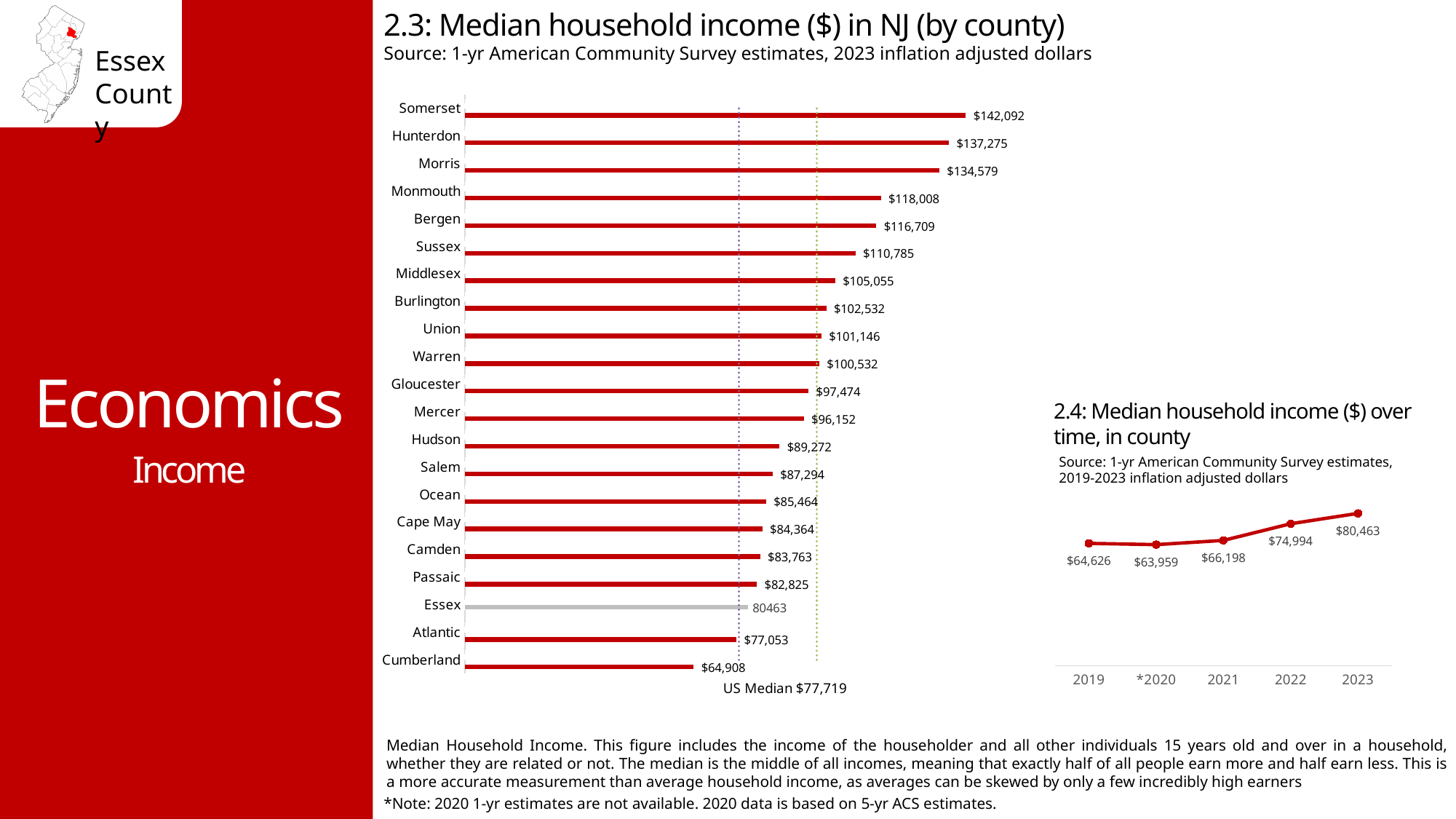
In chart 2.3 (Median household income in NJ by county), what is the median household income for Somerset? $142,092 In chart 2.4 (Median household income over time, in county), which year has the lowest median household income? *2020 In chart 2.4 (Median household income over time, in county), what is the difference between the 2023 and 2019 values? $15,837 In chart 2.3 (Median household income in NJ by county), which county has the lowest median household income? Cumberland In chart 2.3 (Median household income in NJ by county), which county has the highest median household income? Somerset In chart 2.3 (Median household income in NJ by county), what US median value is noted below the chart? $77,719 In chart 2.3 (Median household income in NJ by county), what is the difference between Somerset's and Hunterdon's median household income? $4,817 In chart 2.4 (Median household income over time, in county), what is the median household income for 2023? $80,463 In chart 2.3 (Median household income in NJ by county), which county has a higher median household income, Bergen or Hudson? Bergen In chart 2.3 (Median household income in NJ by county), what is the median household income for Essex? 80463 In chart 2.3 (Median household income in NJ by county), how many counties are shown? 21 What kind of chart is chart 2.3 (Median household income in NJ by county)? Bar chart